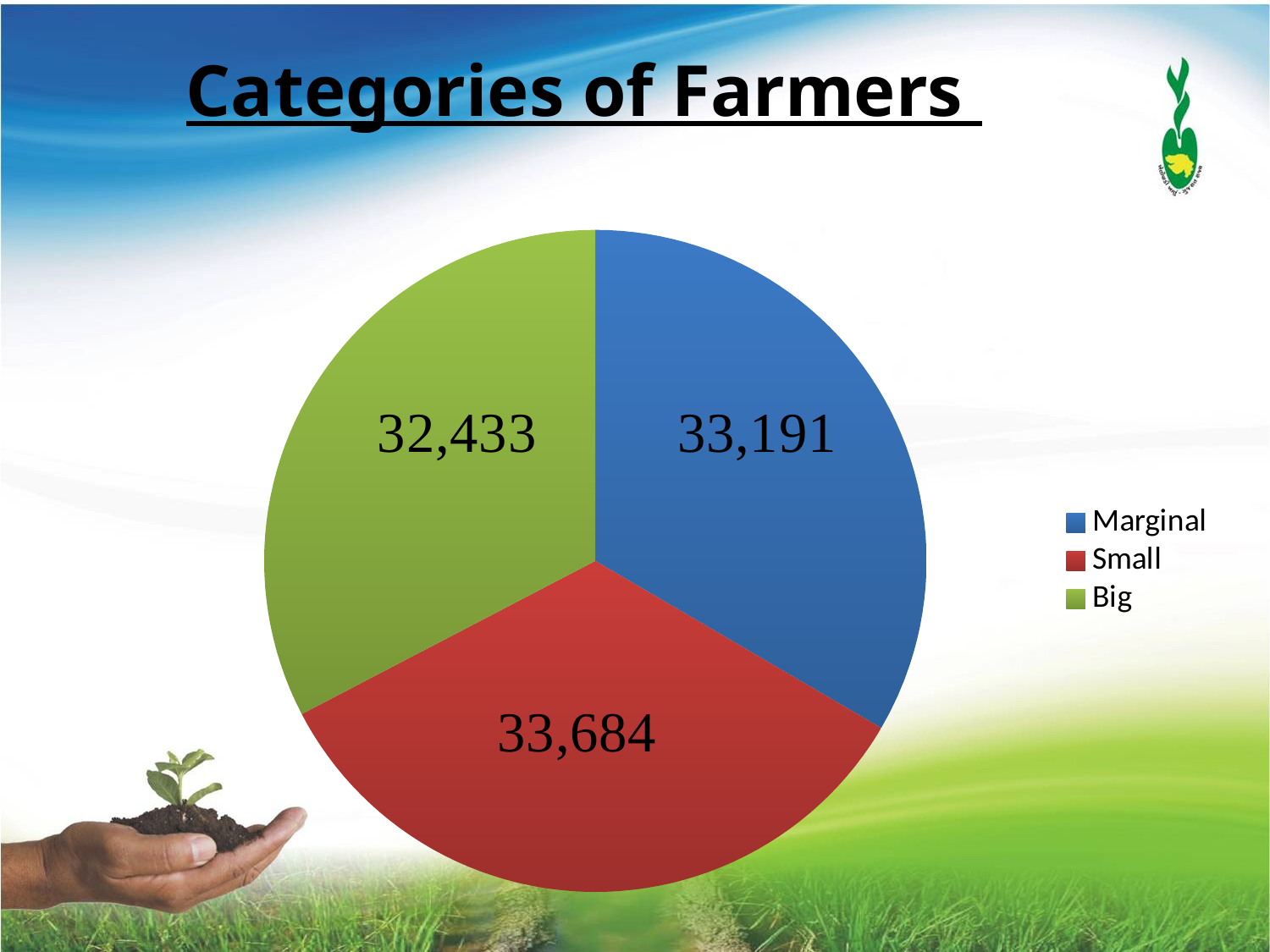
What is the difference between the Small and Marginal values? 493 What is the value for the Big category of farmers? 32,433 What is the value for the Marginal category of farmers? 33,191 Which is larger, the value for Small or the value for Big? Small What is the difference between the Marginal and Big values? 758 How many categories does the pie chart show? 3 What is the title of the chart? Categories of Farmers What is the value for the Small category of farmers? 33,684 Which category of farmers has the lowest value? Big What type of chart is shown on the slide? Pie chart Which category of farmers has the highest value? Small Which colour represents the Big category in the legend? Green